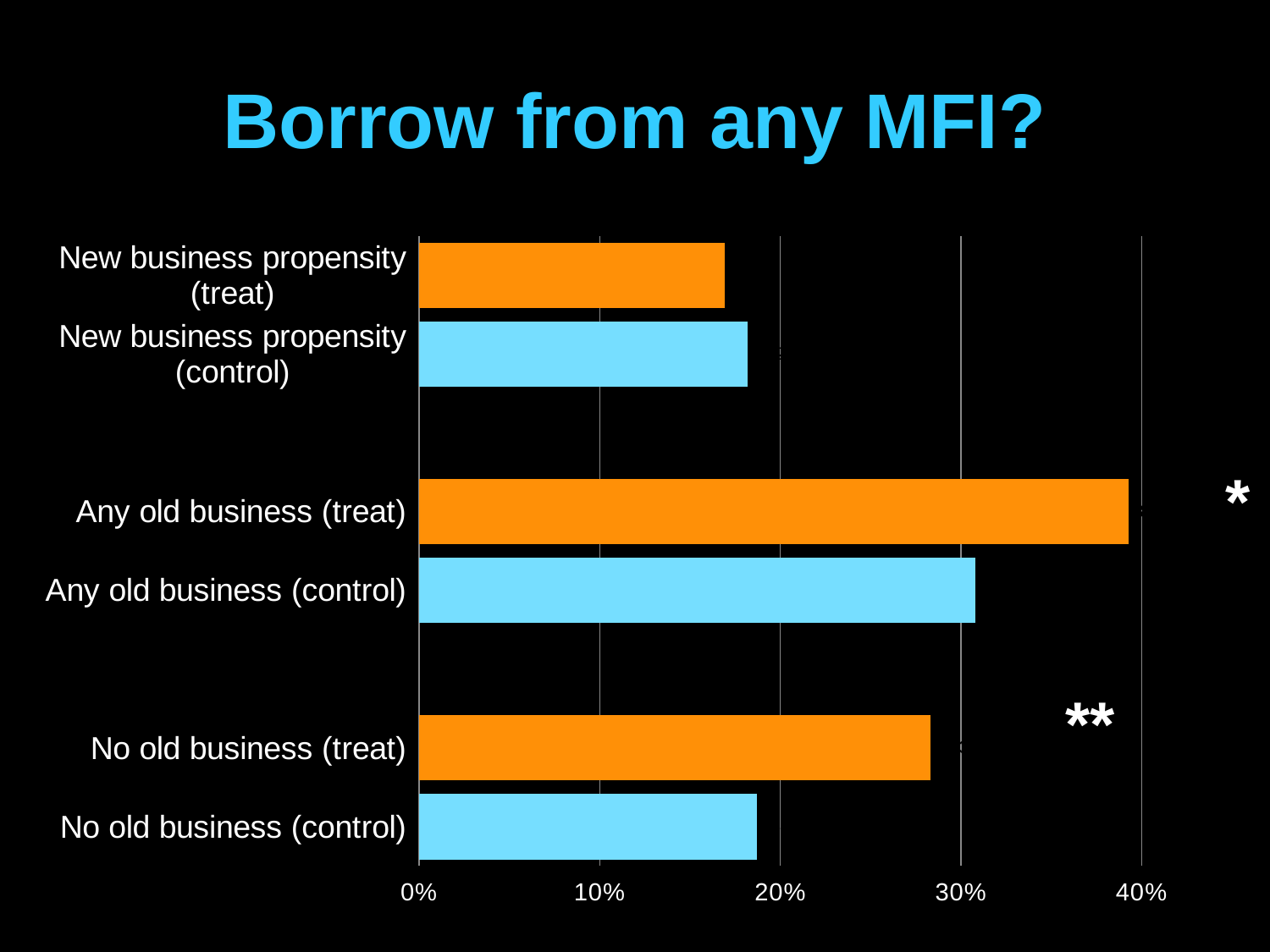
Is the value for New business propensity (treat) greater or less than 20%? less Which is larger: the value for Any old business (treat) or Any old business (control)? Any old business (treat) What is the highest value shown on the horizontal axis? 40% Is the value for Any old business (control) greater or less than 40%? less How many categories (bars) are plotted in the chart? 6 What is the title of the chart? Borrow from any MFI? Which category has the highest value? Any old business (treat) Is the value for No old business (control) greater or less than 20%? less What kind of chart is shown on the slide? bar chart Which is larger: the value for No old business (treat) or No old business (control)? No old business (treat)